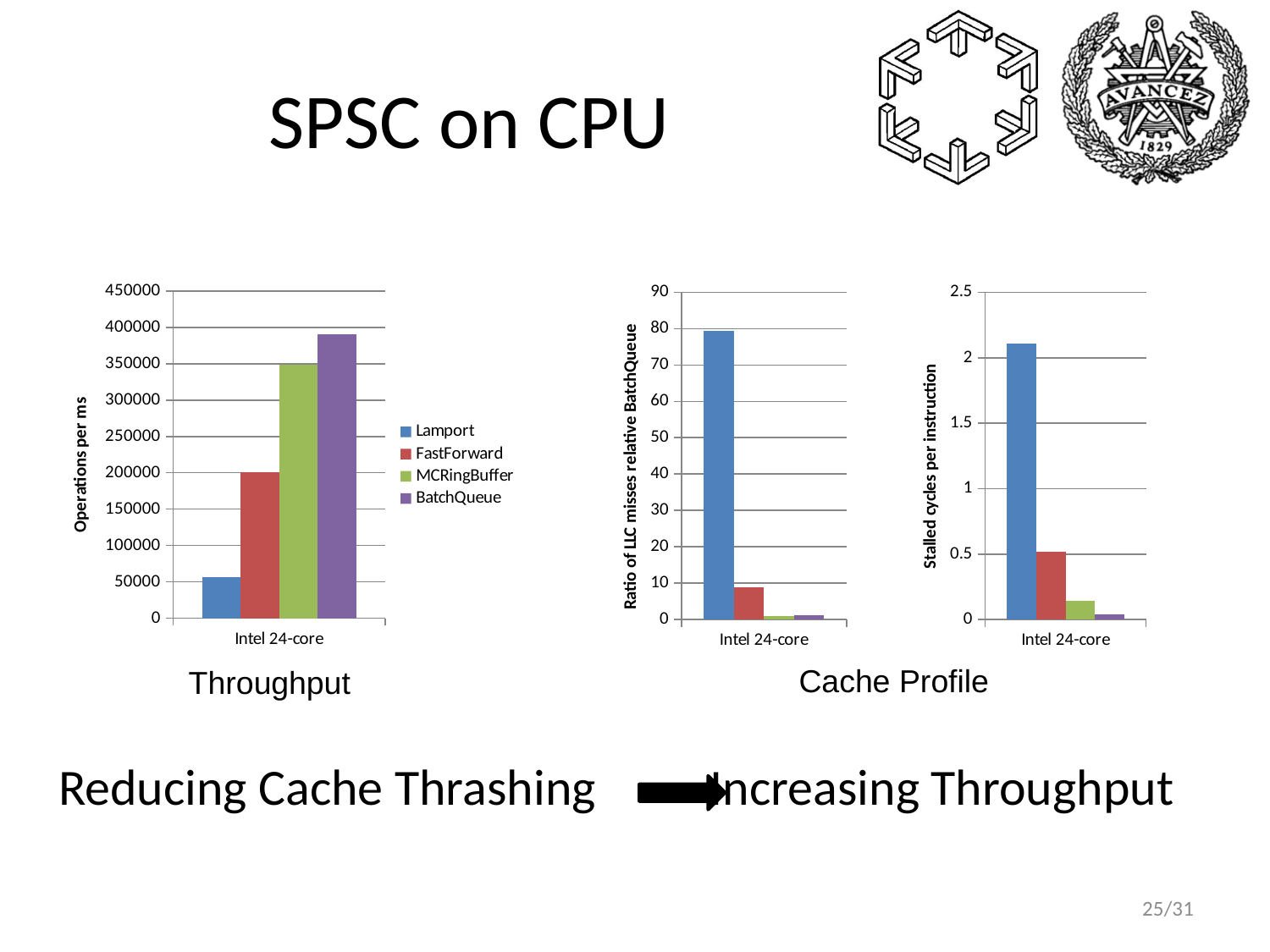
How many series does the legend of the Throughput chart list? 4 In the Throughput chart, is the value for BatchQueue greater or less than 350000? greater In the Throughput chart, which series has the lowest value? Lamport What is the y-axis label of the Throughput chart? Operations per ms In the Throughput chart, which is larger, MCRingBuffer or FastForward? MCRingBuffer In the Throughput chart, is the value for Lamport greater or less than 100000? less In the Throughput chart, which series has the highest value? BatchQueue In the right chart (Stalled cycles per instruction), is the blue (Lamport) bar greater or less than 2? greater What kind of chart is the Throughput chart? bar chart How many categories are shown on the x axis of the right chart (Stalled cycles per instruction)? 1